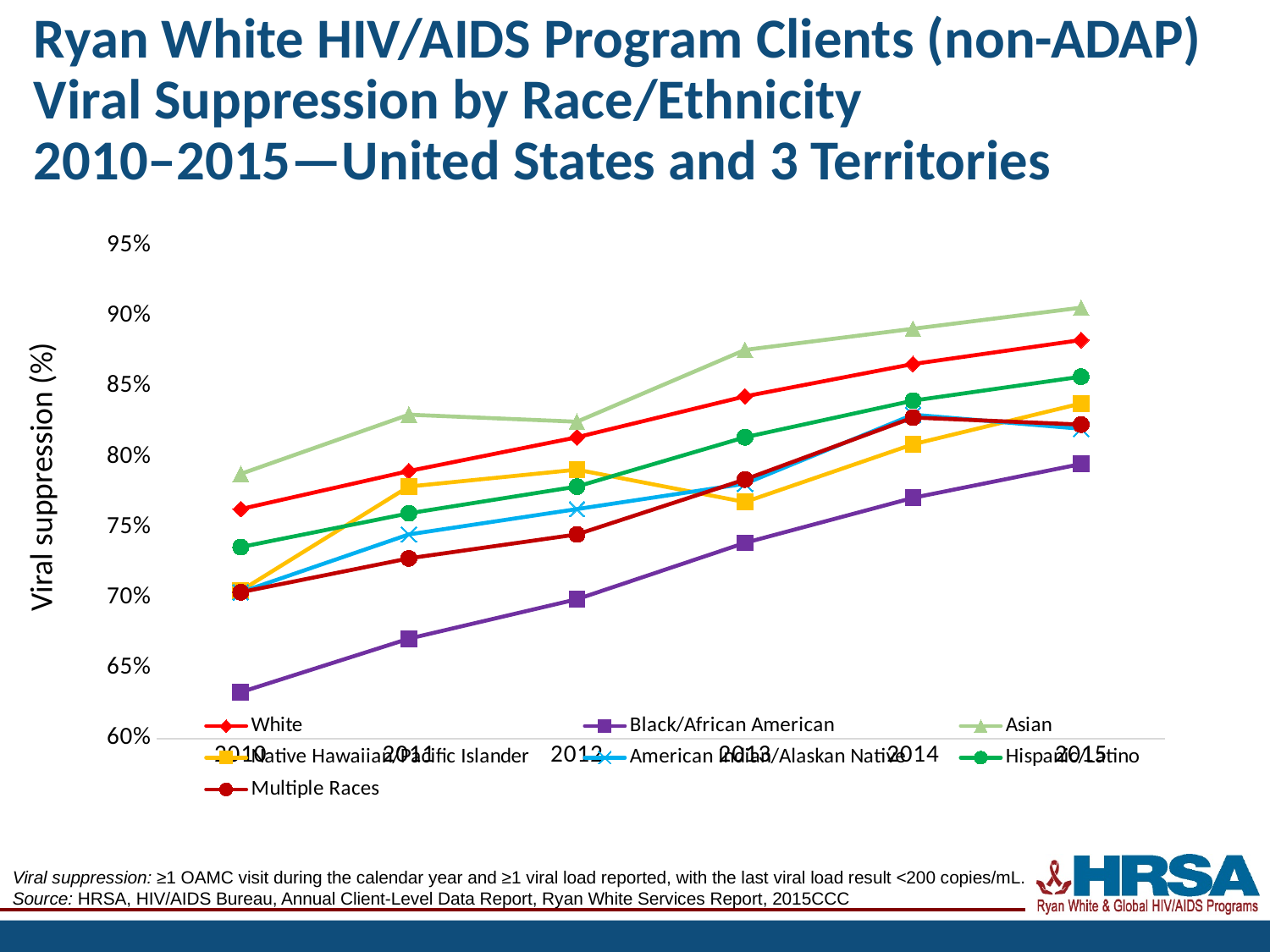
Is the value for Black/African American in 2010 greater or less than 65%? less Is the value for Hispanic/Latino in 2010 greater or less than 75%? less What kind of chart is shown on the slide? Line chart How many series does the legend list? 7 How many years are plotted along the x axis? 6 Is the value for Asian in 2013 greater or less than 85%? greater Which race/ethnicity group has the highest viral suppression in 2015? Asian Does the viral suppression for Black/African American clients rise or fall from 2010 to 2015? Rise What is the label on the y axis? Viral suppression (%) Which race/ethnicity group has the lowest viral suppression in 2015? Black/African American In 2013, which is larger: the value for White or the value for Black/African American? White Which race/ethnicity group has the lowest viral suppression in 2010? Black/African American